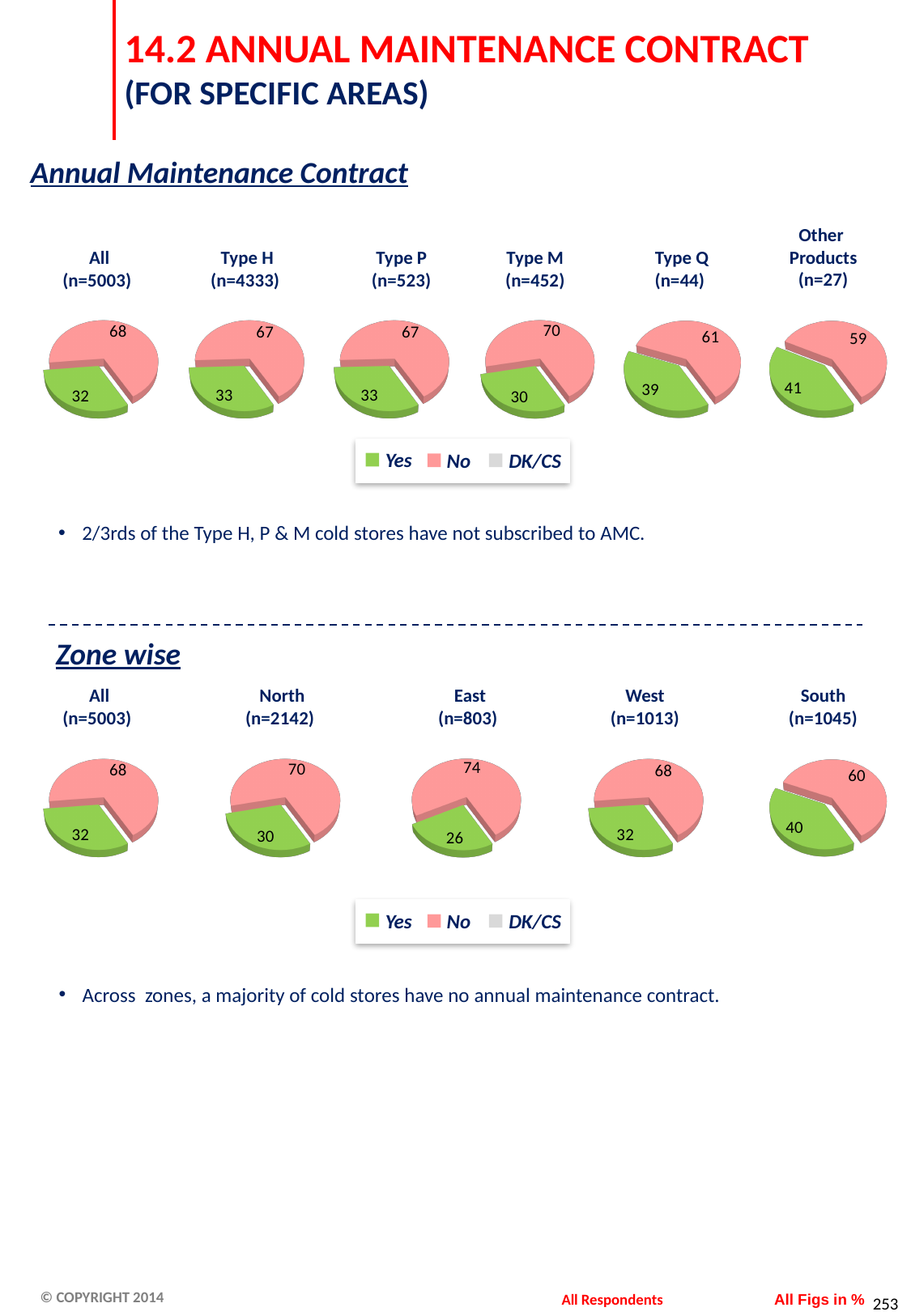
How many pie charts are shown in the Zone wise section? 5 What type of chart is used in the Zone wise section? Pie chart How many entries does the legend below the Annual Maintenance Contract pie charts list? 3 In the Annual Maintenance Contract section, is the 'Yes' value larger for Type Q or for Type M? Type Q In the Annual Maintenance Contract section, what is the 'No' value in the Other Products (n=27) pie chart? 59 In the Zone wise section, what is the 'Yes' value in the East (n=803) pie chart? 26 In the Zone wise section, which pie chart has the lowest 'Yes' value? East (n=803) In the Zone wise section, what is the difference between the 'No' values for East and South? 14 In the Zone wise section, what colour represents 'Yes' in the legend? Green In the Annual Maintenance Contract section, which pie chart has the highest 'Yes' value? Other Products (n=27) In the Zone wise section, what is the 'No' value in the South (n=1045) pie chart? 60 In the Annual Maintenance Contract section, what is the 'Yes' value in the Type Q (n=44) pie chart? 39